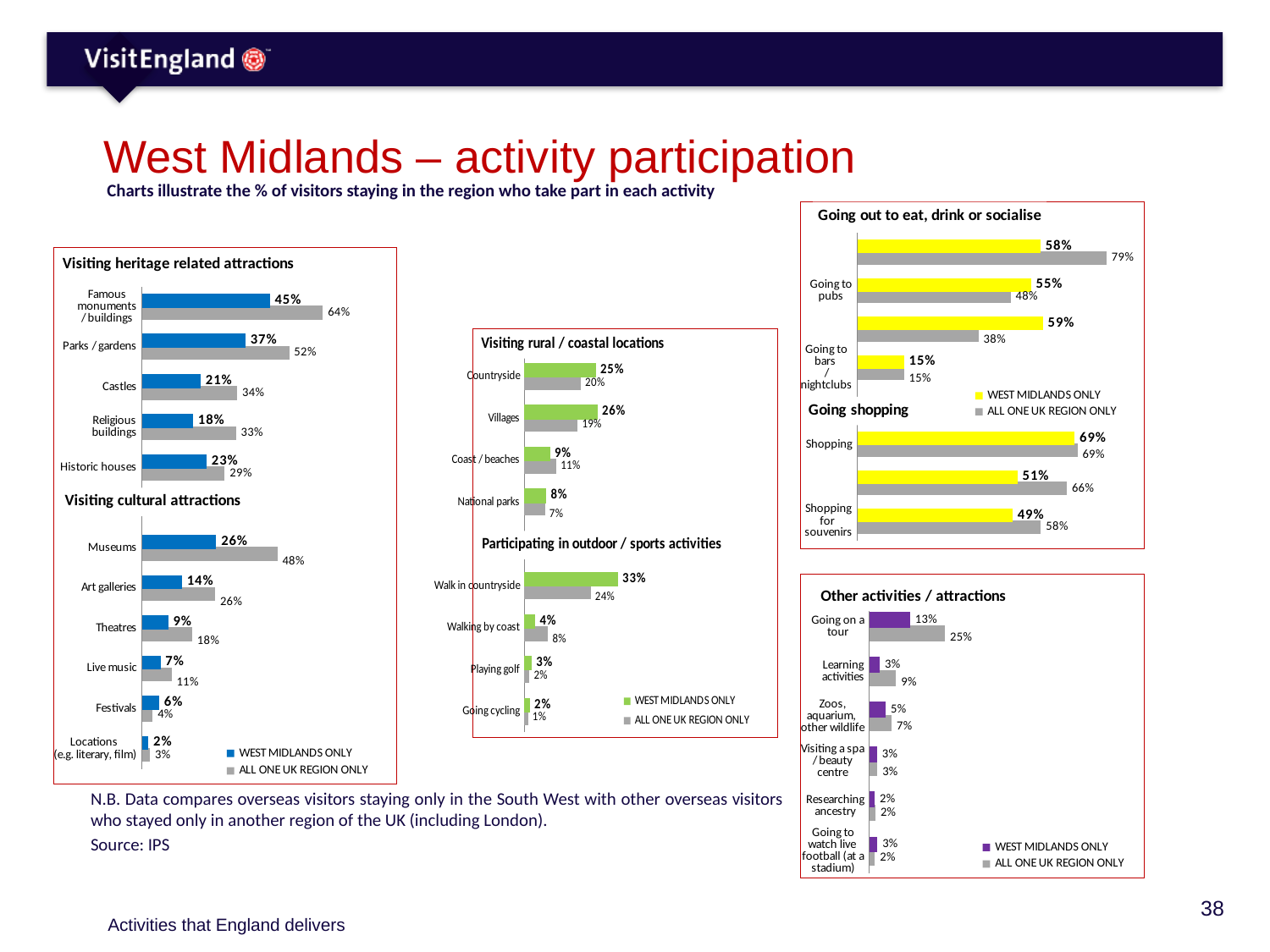
How many series does the legend of the 'Going out to eat, drink or socialise' chart list? 2 In the 'Visiting rural / coastal locations' chart, is the West Midlands only value for Coast / beaches larger or smaller than the All one UK region only value? smaller In the 'Visiting heritage related attractions' chart, what is the All one UK region only value for Parks / gardens? 52% How many categories are shown in the 'Participating in outdoor / sports activities' chart? 4 In the 'Visiting heritage related attractions' chart, which category has the highest West Midlands only value? Famous monuments / buildings In the 'Visiting rural / coastal locations' chart, what is the West Midlands only value for Villages? 26% In the 'Other activities / attractions' chart, what is the All one UK region only value for Going on a tour? 25% In the 'Going shopping' chart, what is the West Midlands only value for Shopping for souvenirs? 49% In the 'Participating in outdoor / sports activities' chart, what is the All one UK region only value for Walk in countryside? 24% In the 'Visiting cultural attractions' chart, what is the difference between the All one UK region only and West Midlands only values for Museums? 22% In the 'Visiting cultural attractions' chart, which category has the lowest West Midlands only value? Locations (e.g. literary, film) In the 'Visiting heritage related attractions' chart, what is the West Midlands only value for Castles? 21%